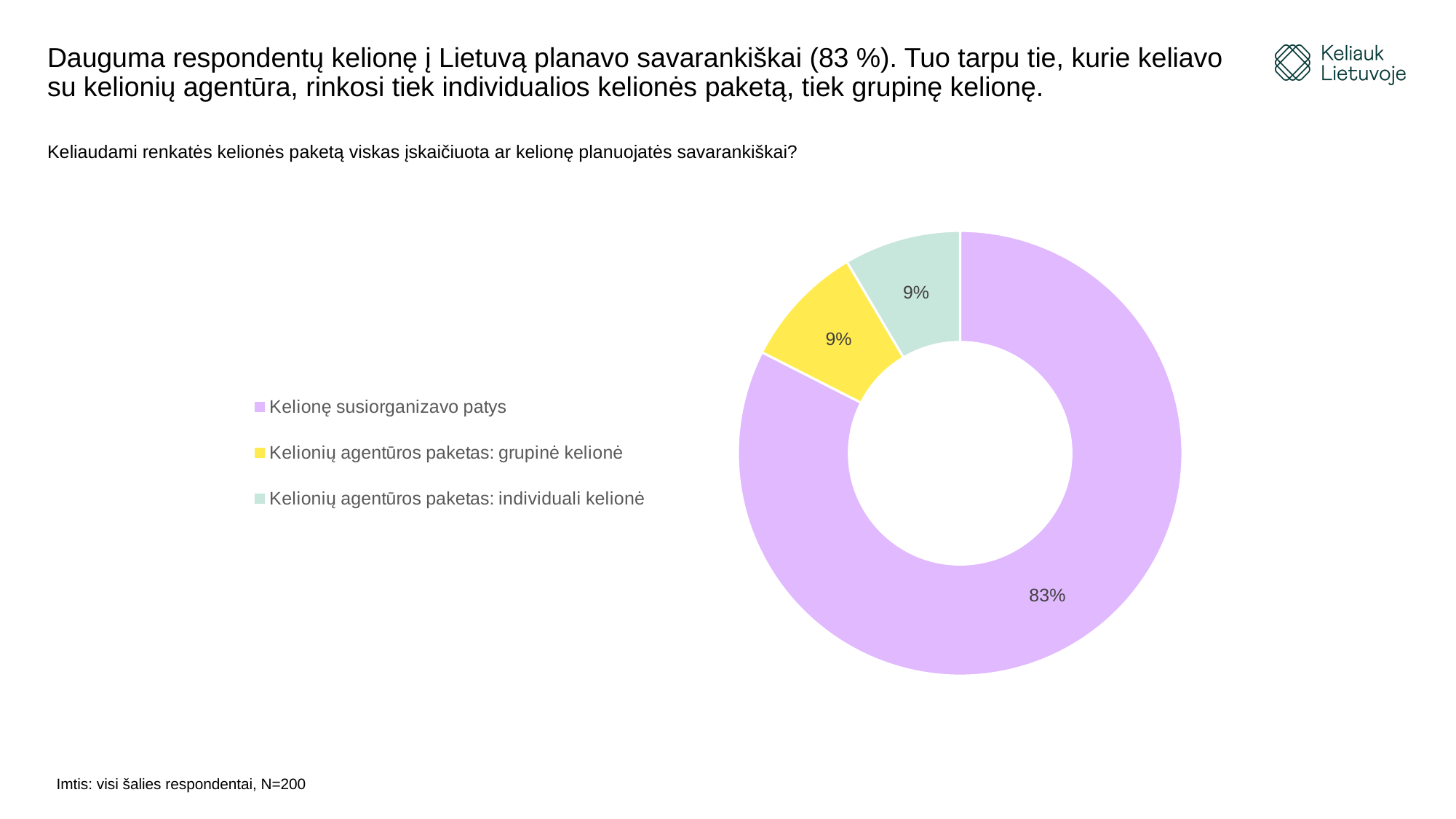
How many categories are shown in the chart? 3 Which is larger: the share for 'Kelionę susiorganizavo patys' or for 'Kelionių agentūros paketas: individuali kelionė'? Kelionę susiorganizavo patys What share of respondents organised the trip themselves (Kelionę susiorganizavo patys)? 83% What percentage chose a travel agency group trip package (Kelionių agentūros paketas: grupinė kelionė)? 9% What sample size is stated on the slide? N=200 What is the difference in percentage points between 'Kelionę susiorganizavo patys' and 'Kelionių agentūros paketas: grupinė kelionė'? 74 percentage points What kind of chart is shown on the slide? Pie (donut) chart How many entries does the legend list? 3 What colour is the slice for 'Kelionių agentūros paketas: grupinė kelionė'? Yellow What percentage chose a travel agency individual trip package (Kelionių agentūros paketas: individuali kelionė)? 9% Which category has the largest share in the chart? Kelionę susiorganizavo patys What share of the pie does the 'Kelionę susiorganizavo patys' slice represent? 83%